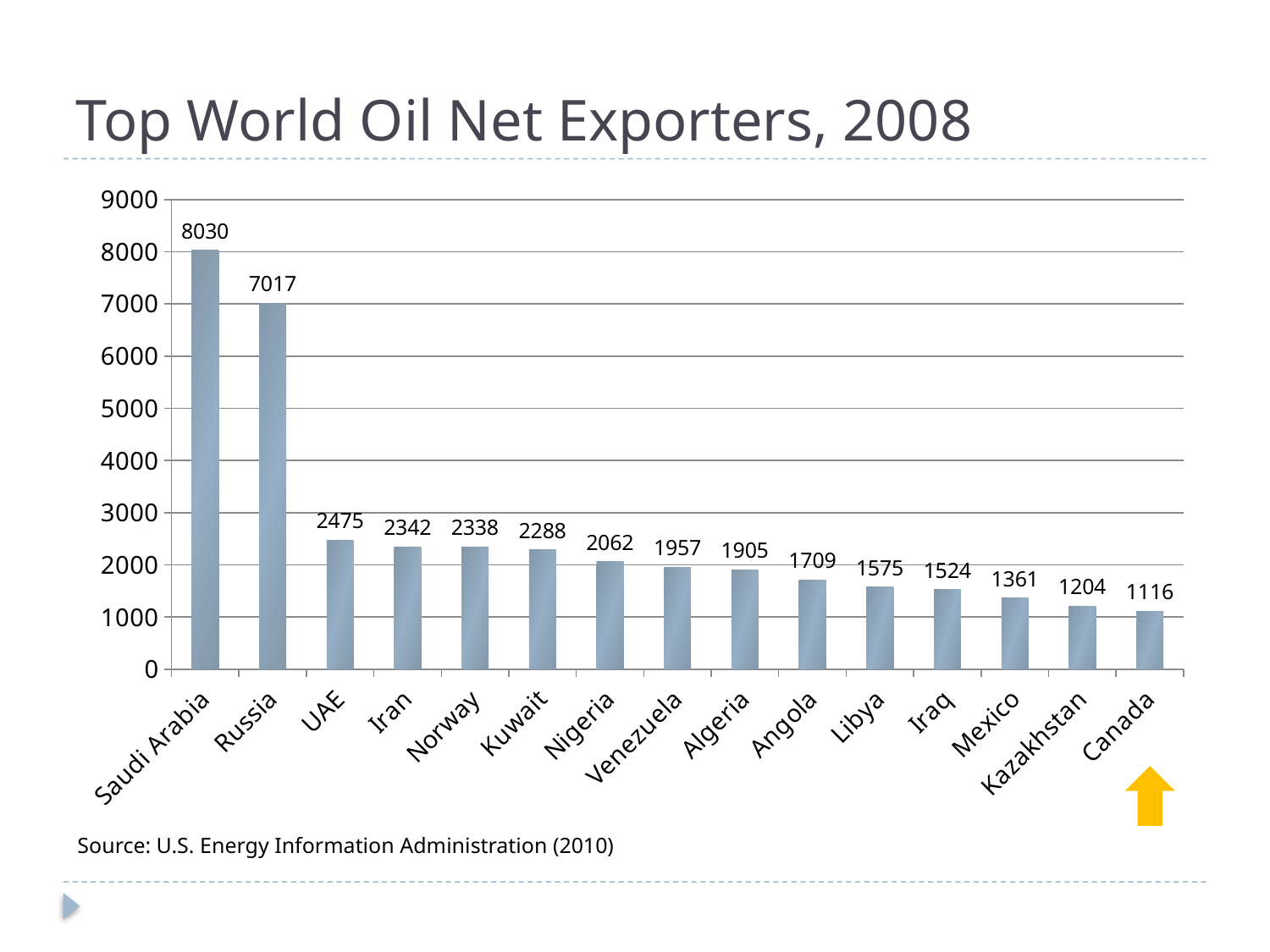
How many countries are shown on the chart? 15 What is the value for Canada? 1116 Is the value for Russia greater or less than 6000? greater What is the title of the slide? Top World Oil Net Exporters, 2008 Which country has the highest value? Saudi Arabia What is the difference between the values for Saudi Arabia and Russia? 1013 Which country has the lowest value? Canada What kind of chart is shown on the slide? Bar chart What is the difference between the values for UAE and Iran? 133 What is the value for Saudi Arabia? 8030 What is the value for Nigeria? 2062 Which is larger, the value for Kuwait or the value for Venezuela? Kuwait